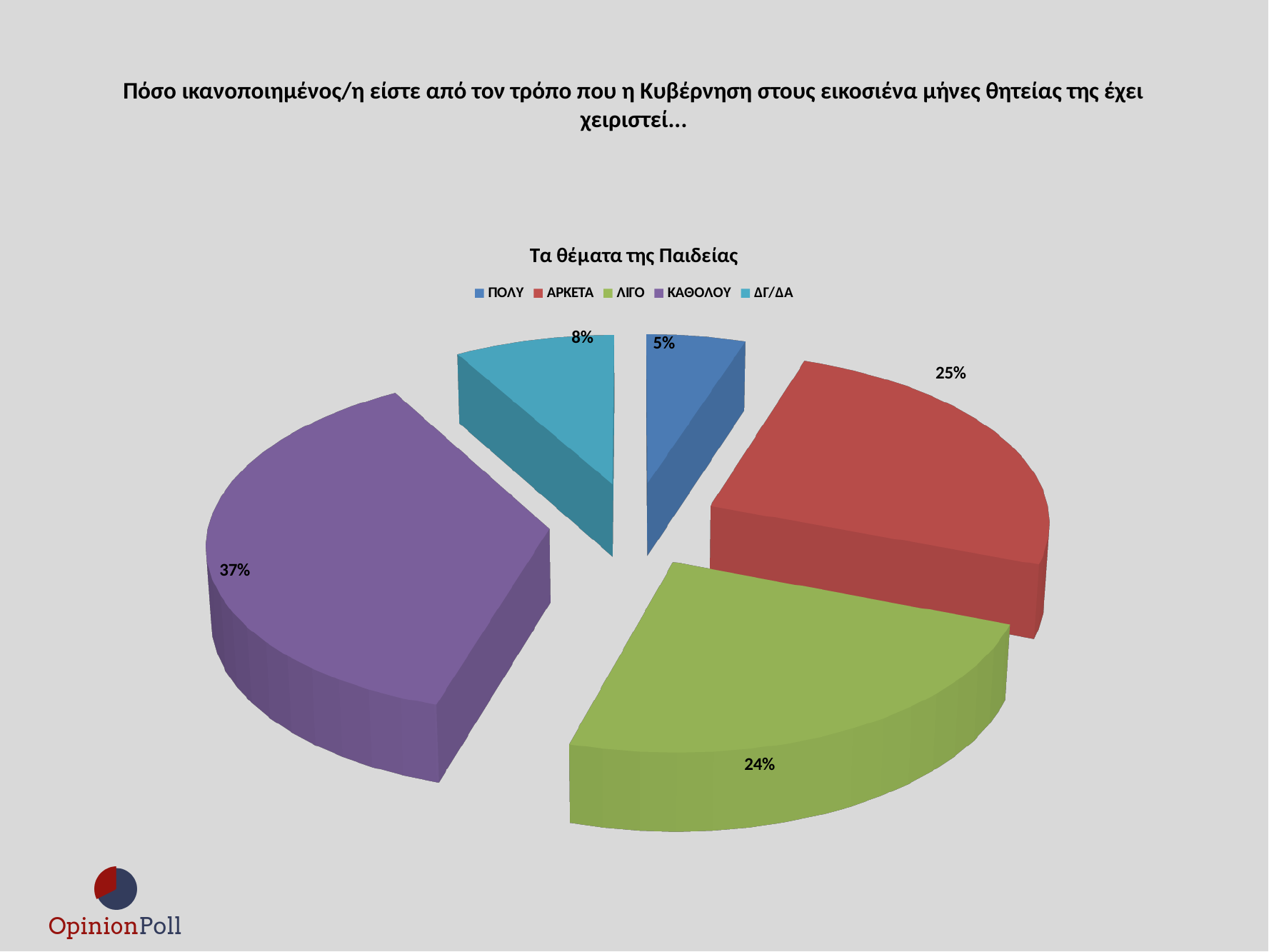
What percentage is shown for ΚΑΘΟΛΟΥ? 37% What percentage is shown for ΑΡΚΕΤΑ? 25% Which category has the smallest share of the pie? ΠΟΛΥ What percentage is shown for ΔΓ/ΔΑ? 8% What percentage is shown for ΠΟΛΥ? 5% Which category has the largest share of the pie? ΚΑΘΟΛΟΥ How many categories does the legend list? 5 What is the difference in percentage points between ΚΑΘΟΛΟΥ and ΛΙΓΟ? 13 Which is larger, the share for ΔΓ/ΔΑ or the share for ΠΟΛΥ? ΔΓ/ΔΑ Which colour represents ΛΙΓΟ in the chart? green What is the title of the chart? Τα θέματα της Παιδείας What kind of chart is shown on the slide? pie chart